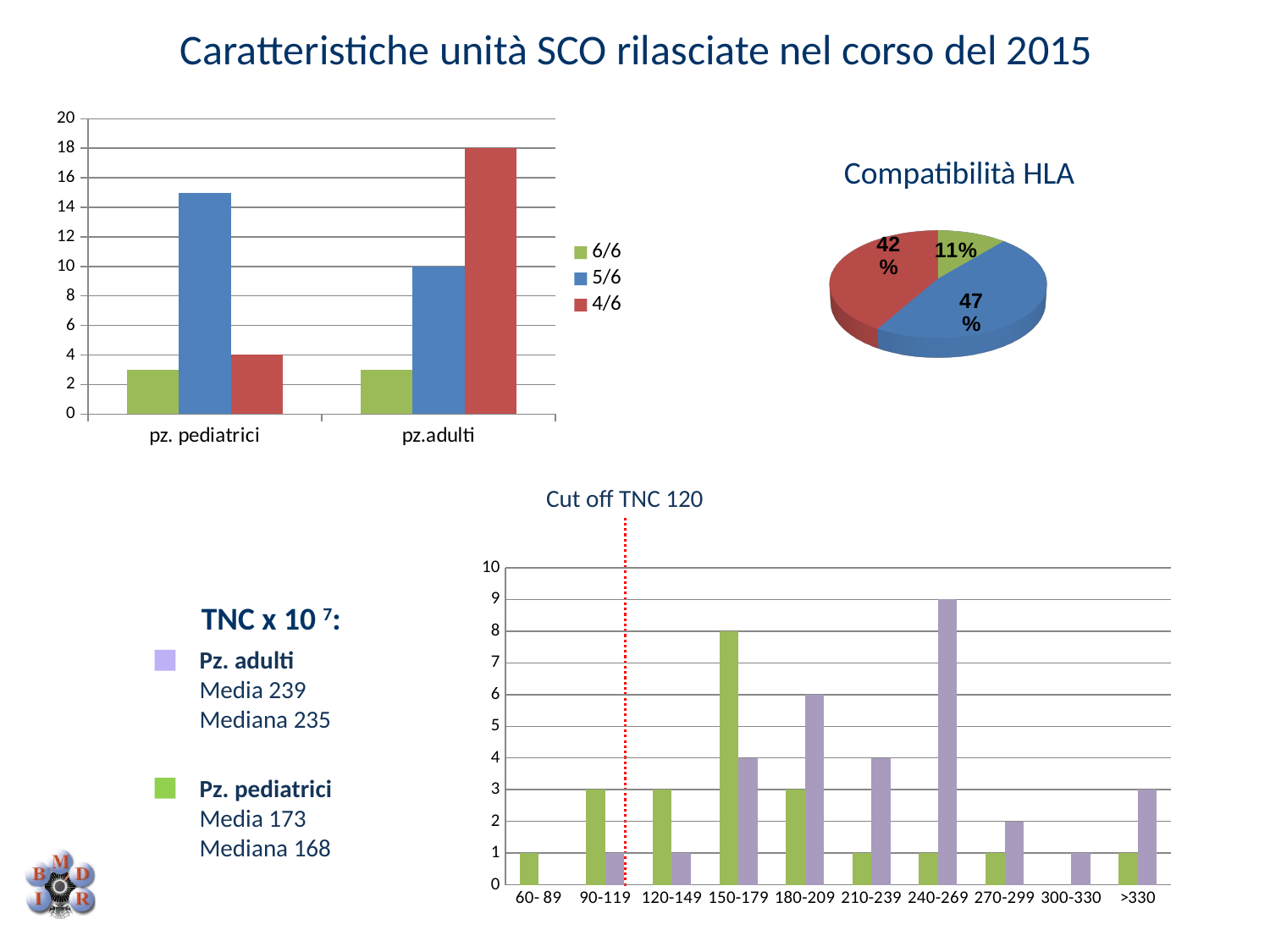
What type of chart is the bottom chart on the slide? bar chart In the Compatibilità HLA pie chart, what is the percentage of the smallest slice? 11% In the top-left bar chart, is the 5/6 value for pz. pediatrici greater or less than 14? greater In the bottom bar chart, what is the value for Pz. pediatrici in the 150-179 category? 8 In the top-left bar chart, how many series does the legend list? 3 In the top-left bar chart, what is the value of the 4/6 series for pz. pediatrici? 4 In the bottom bar chart, which category has the highest value for Pz. adulti? 240-269 In the Compatibilità HLA pie chart, what share does the largest slice have? 47% In the top-left bar chart, what is the value of the 5/6 series for pz.adulti? 10 In the bottom bar chart, what is the difference between the Pz. adulti and Pz. pediatrici values in the 180-209 category? 3 In the bottom bar chart, how many categories are shown on the x axis? 10 In the top-left bar chart, what is the value of the 4/6 series for pz.adulti? 18